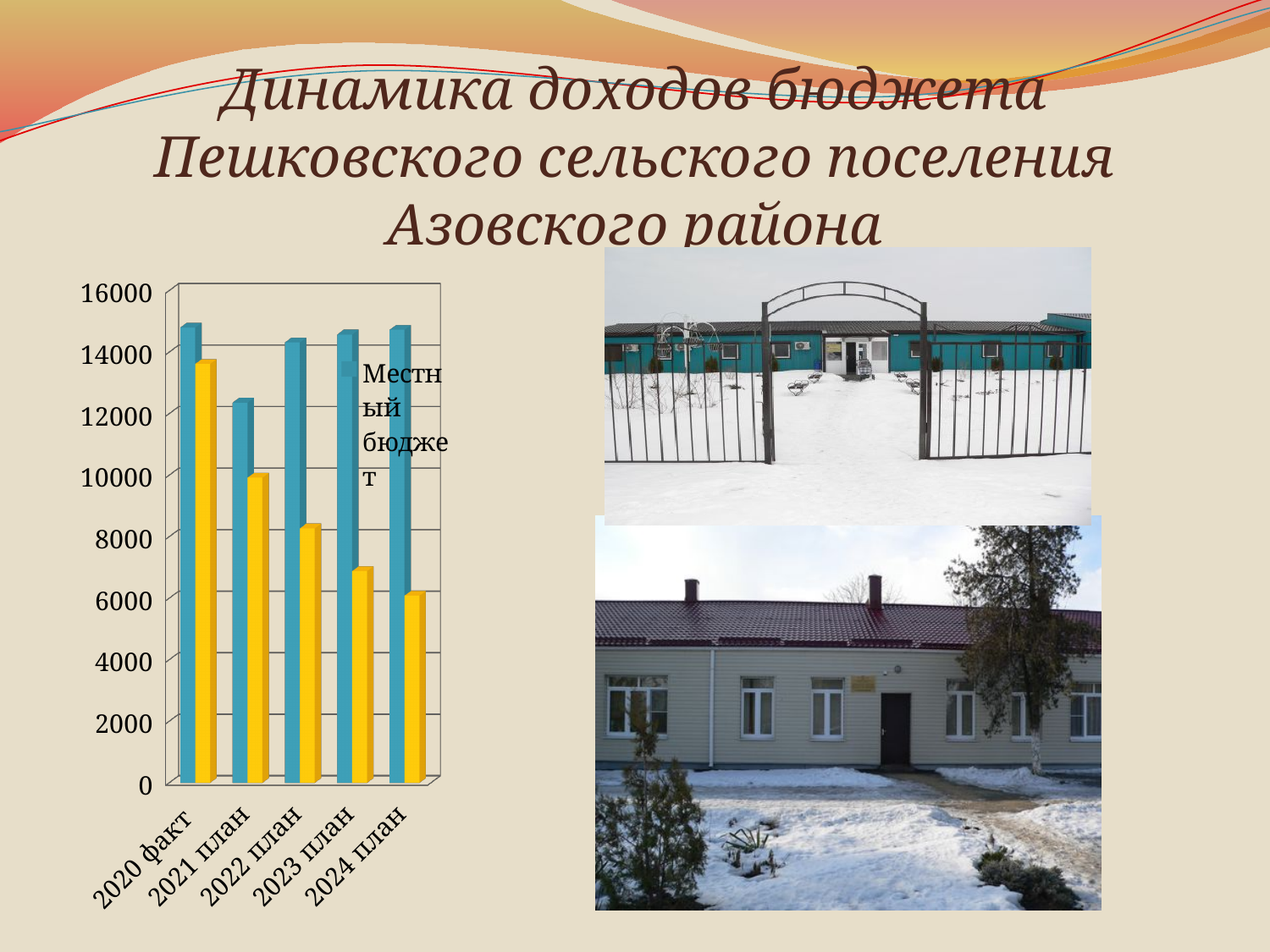
Is the blue bar for 2021 план greater or less than 14000? less How many categories are shown on the x axis of the chart? 5 Is the yellow bar for 2024 план greater or less than 8000? less Do the yellow bars rise or fall from 2020 факт to 2024 план? fall Which category has the highest yellow bar? 2020 факт Is the yellow bar for 2022 план greater or less than 6000? greater What kind of chart is shown on the slide? bar chart What is the title of the slide containing the chart? Динамика доходов бюджета Пешковского сельского поселения Азовского района Which category has the lowest blue bar? 2021 план Which category has the lowest yellow bar? 2024 план For 2023 план, which bar is larger, the blue one or the yellow one? the blue one